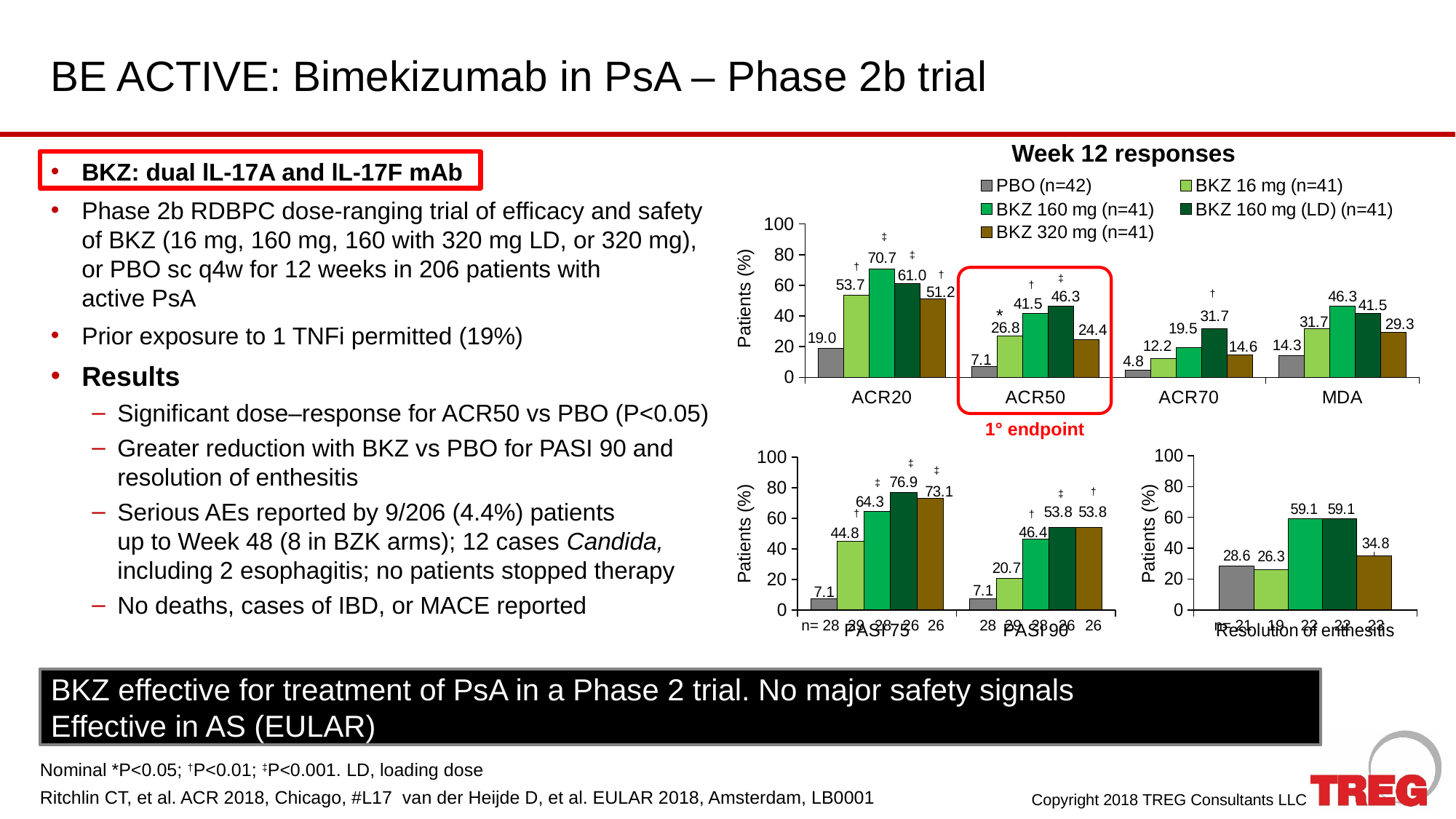
In the top chart (Week 12 responses), which treatment group has the lowest ACR70 response? PBO (n=42) How many treatment groups does the legend of the Week 12 responses charts list? 5 How many response categories are shown on the x axis of the top chart (Week 12 responses)? 4 In the top chart (Week 12 responses), what is the ACR20 value for PBO (n=42)? 19.0 In the top chart (Week 12 responses), which treatment group has the highest ACR20 response? BKZ 160 mg (n=41) In the top chart (Week 12 responses), what is the ACR50 value for BKZ 160 mg (LD) (n=41)? 46.3 In the bottom-left chart, what is the PASI 75 value for BKZ 160 mg (LD)? 76.9 In the top chart (Week 12 responses), which category is highlighted as the 1° endpoint? ACR50 In the top chart (Week 12 responses), for MDA, which is larger: BKZ 160 mg or BKZ 160 mg (LD)? BKZ 160 mg What type of chart is used to show the Week 12 responses? Bar chart In the bottom-right chart (Resolution of enthesitis), what is the value for BKZ 320 mg? 34.8 In the top chart (Week 12 responses), what is the difference between the ACR50 values for BKZ 160 mg (LD) and PBO? 39.2